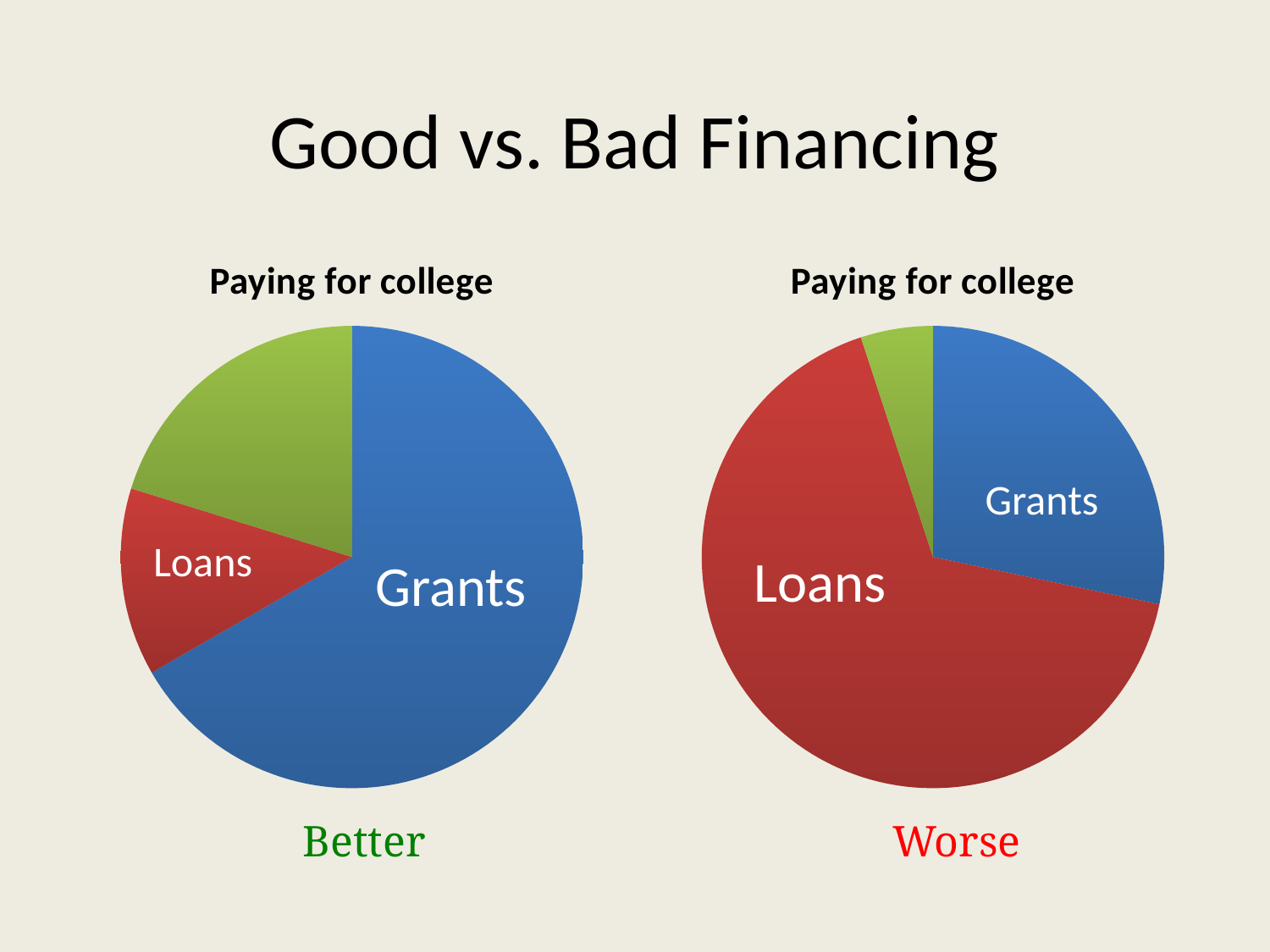
In the right pie chart (labelled "Worse"), which labelled slice is the largest? Loans What kind of chart is the right chart labelled "Worse"? Pie chart In the right pie chart (labelled "Worse"), which is larger, Grants or Loans? Loans In the left pie chart (labelled "Better"), which is larger, Grants or Loans? Grants In the left pie chart (labelled "Better"), which labelled slice is the largest? Grants In the right pie chart (labelled "Worse"), what colour is the Loans slice? Red How many slices does the left pie chart (labelled "Better") have? 3 How many slices does the right pie chart (labelled "Worse") have? 3 What kind of chart is the left chart labelled "Better"? Pie chart What is the title of the left pie chart? Paying for college